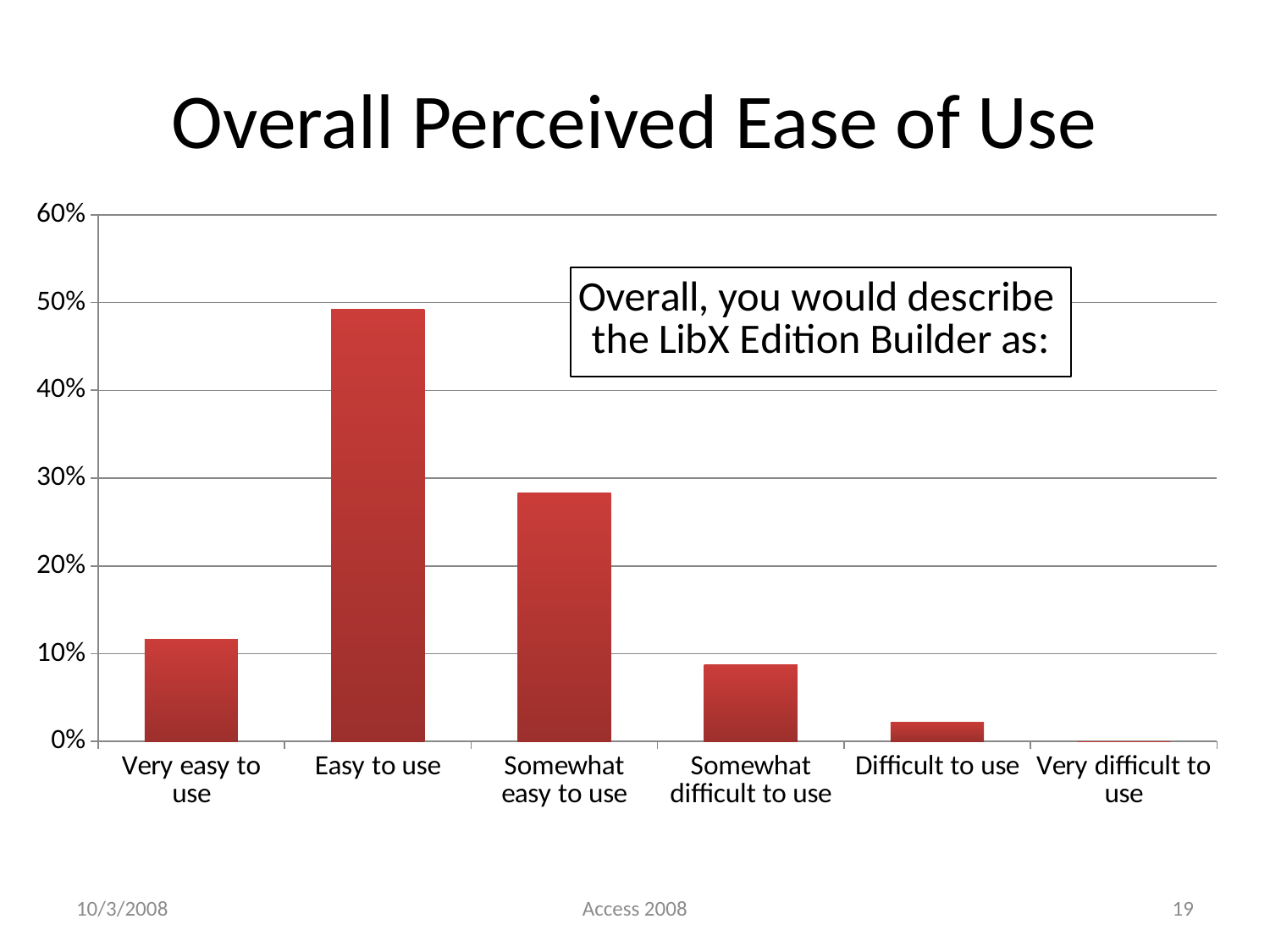
How many categories are shown on the x axis of the chart? 6 Is the value for Somewhat easy to use greater or less than 30%? less Is the value for Difficult to use greater or less than 10%? less Which is larger, the value for Difficult to use or the value for Somewhat difficult to use? Somewhat difficult to use Which category has the highest value? Easy to use Is the value for Somewhat difficult to use greater or less than 10%? less What is the title of the chart on the slide? Overall, you would describe the LibX Edition Builder as: Which is larger, the value for Somewhat easy to use or the value for Very easy to use? Somewhat easy to use Do the values rise or fall moving from Easy to use to Very difficult to use along the x axis? fall What kind of chart is shown on the slide? bar chart Which category has the lowest value? Very difficult to use